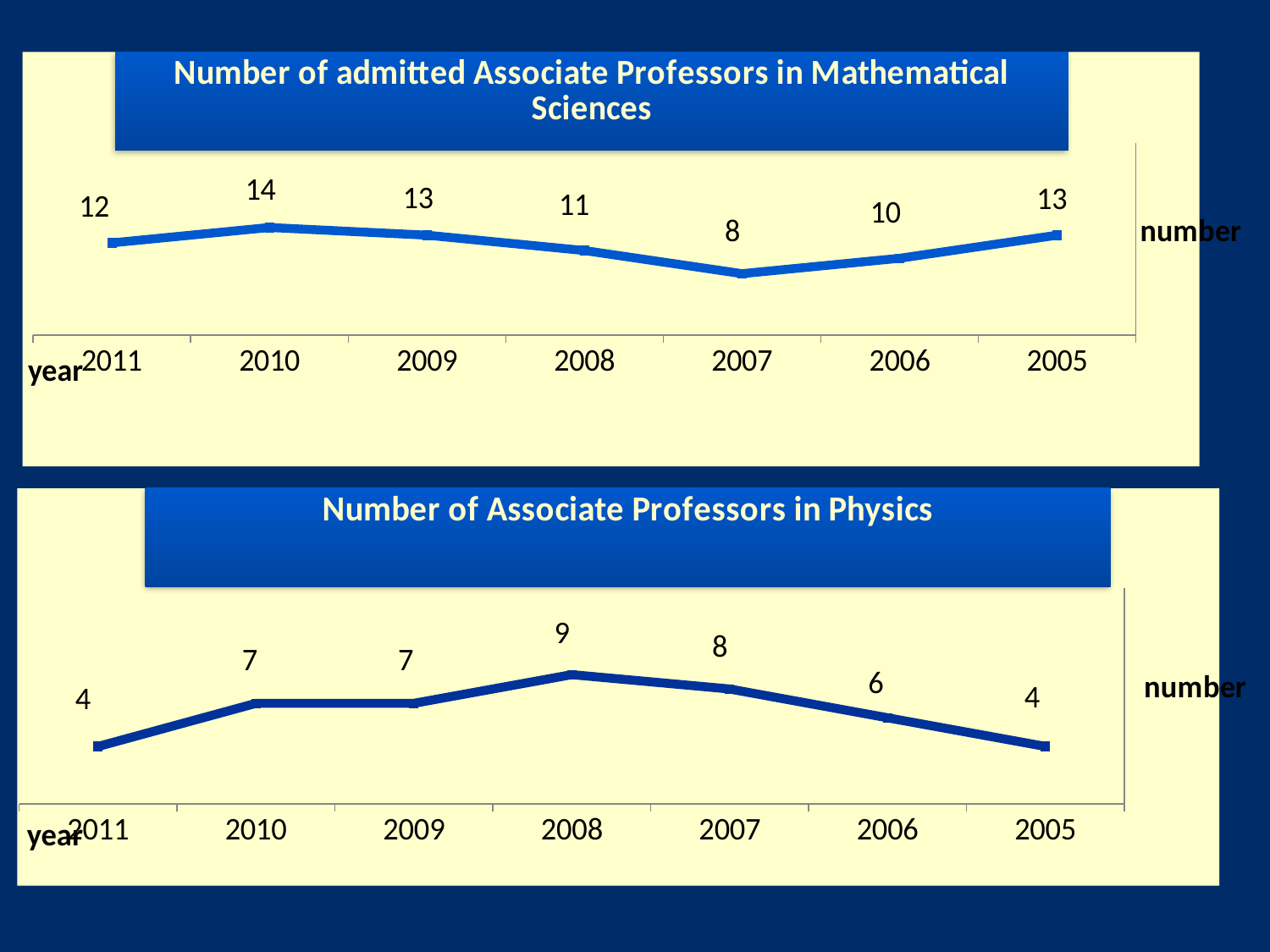
In the 'Number of admitted Associate Professors in Mathematical Sciences' chart, how many years are plotted? 7 In the 'Number of Associate Professors in Physics' chart, what is the value for 2008? 9 In the 'Number of Associate Professors in Physics' chart, what is the difference between the values for 2008 and 2005? 5 In the 'Number of admitted Associate Professors in Mathematical Sciences' chart, which year has the highest value? 2010 What is the title of the bottom chart on the slide? Number of Associate Professors in Physics In the 'Number of admitted Associate Professors in Mathematical Sciences' chart, what is the value for 2007? 8 What kind of chart is the 'Number of Associate Professors in Physics' chart? line chart In the 'Number of admitted Associate Professors in Mathematical Sciences' chart, which year has the lowest value? 2007 In the 'Number of Associate Professors in Physics' chart, which is larger, the value for 2007 or the value for 2006? 2007 In the 'Number of Associate Professors in Physics' chart, which year has the highest value? 2008 In the 'Number of admitted Associate Professors in Mathematical Sciences' chart, what is the value for 2010? 14 In the 'Number of admitted Associate Professors in Mathematical Sciences' chart, what is the difference between the values for 2010 and 2007? 6